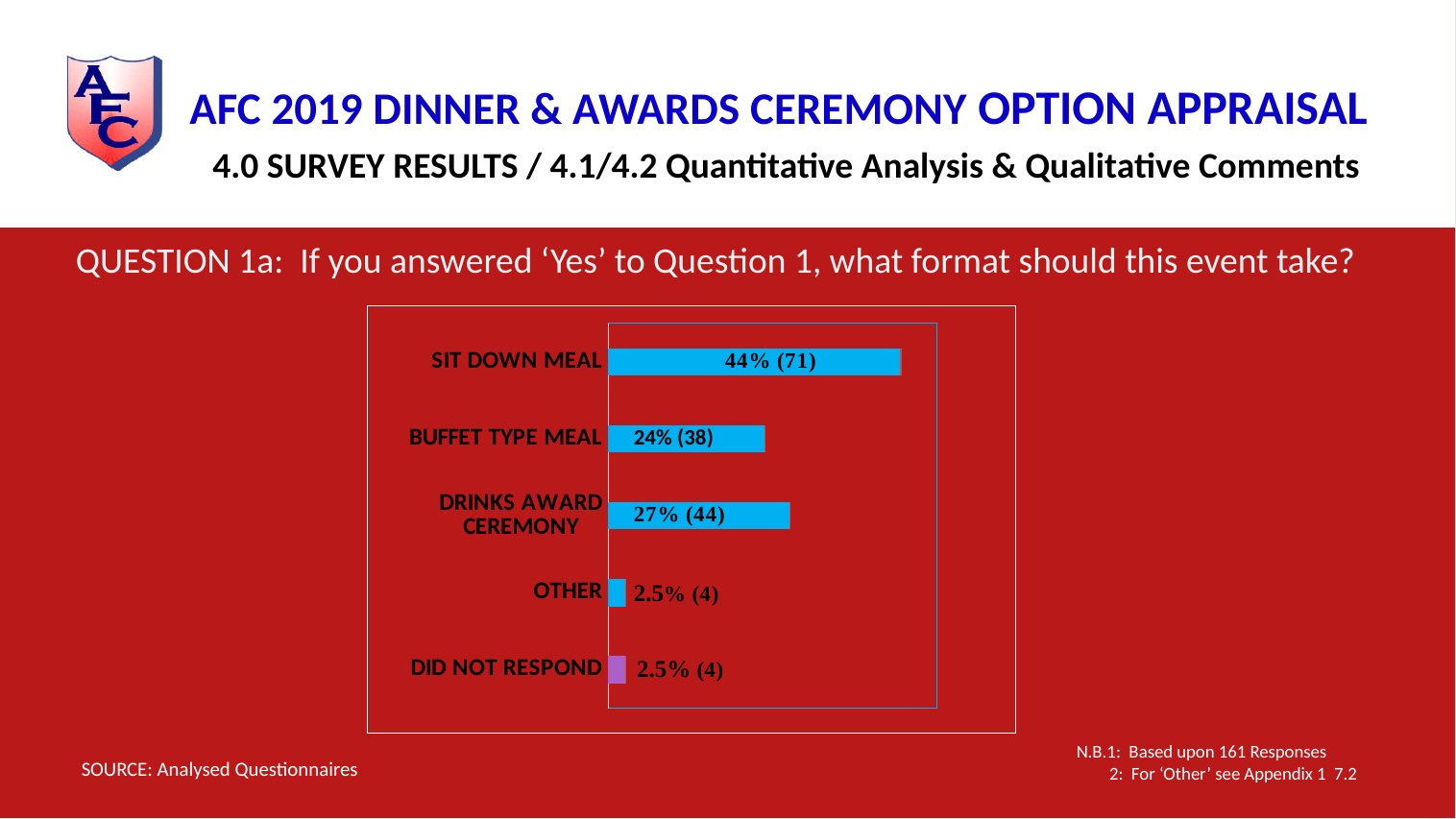
How many categories are shown in the chart? 5 What percentage of respondents chose SIT DOWN MEAL? 44% How many responses are shown for BUFFET TYPE MEAL? 38 What is the difference in percentage points between SIT DOWN MEAL and DRINKS AWARD CEREMONY? 17 How many responses is the chart based upon, according to the note on the slide? 161 Which received more responses, BUFFET TYPE MEAL or DRINKS AWARD CEREMONY? DRINKS AWARD CEREMONY What colour is the DID NOT RESPOND bar? Purple What percentage is shown for DID NOT RESPOND? 2.5% How many more responses did SIT DOWN MEAL receive than BUFFET TYPE MEAL? 33 Which format received the highest share of responses? SIT DOWN MEAL What type of chart is shown on the slide? Bar chart What value is labelled on the DRINKS AWARD CEREMONY bar? 27% (44)